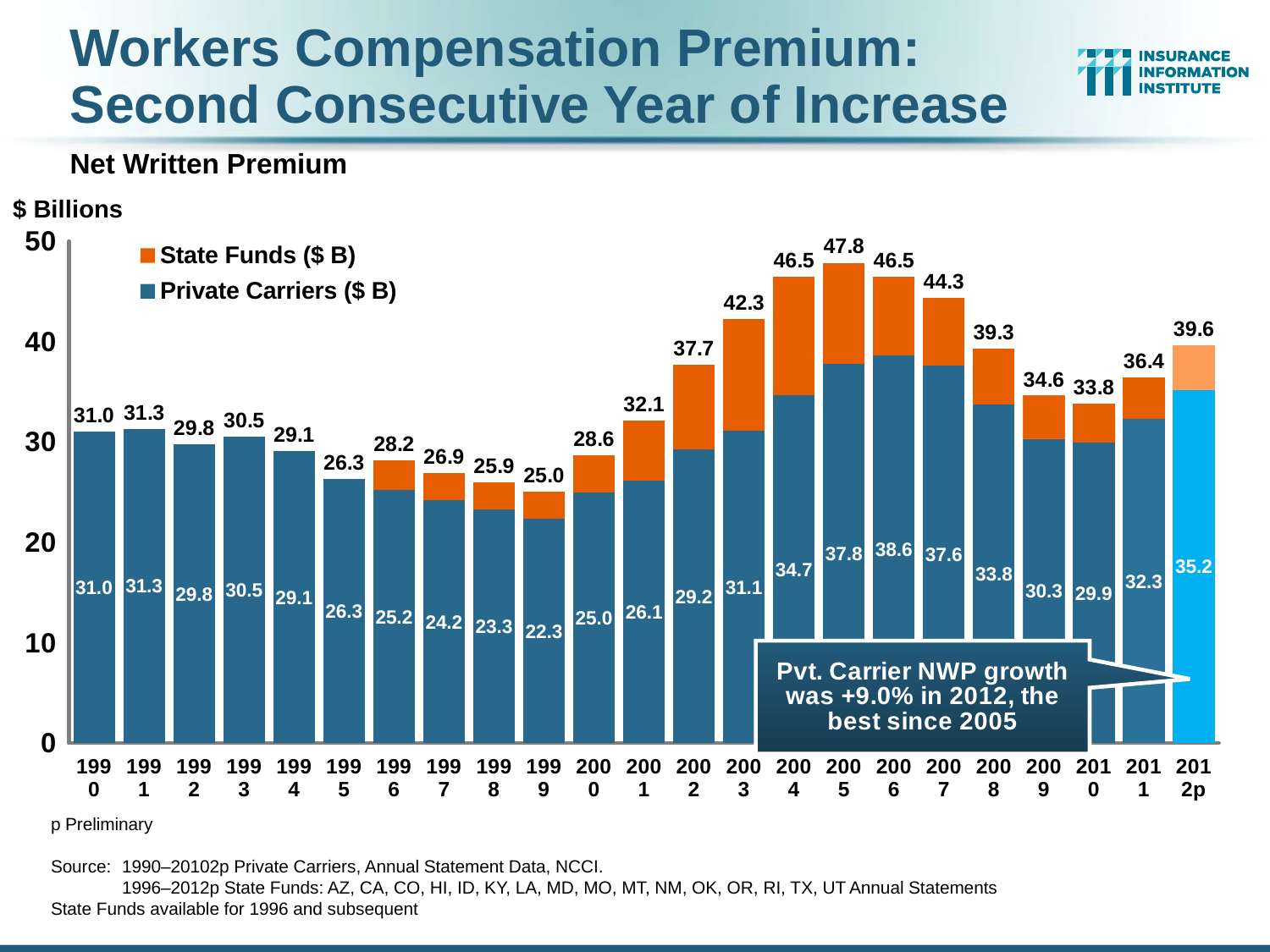
How many years are shown on the x axis of the chart? 23 Did the total net written premium rise or fall from 2005 to 2010? Fall Is the total net written premium for 2003 greater or less than 40? greater What was the State Funds net written premium in 2012p (total minus Private Carriers)? 4.4 What was the total net written premium in 2005? 47.8 What kind of chart is shown on the slide? Stacked bar chart Which year had the highest total net written premium? 2005 What was the Private Carriers net written premium in 2012p? 35.2 By how much did the total net written premium increase from 2011 to 2012p? 3.2 Which year had the lowest total net written premium? 1999 Which year had a higher total net written premium, 2008 or 2009? 2008 How many series does the legend list? 2